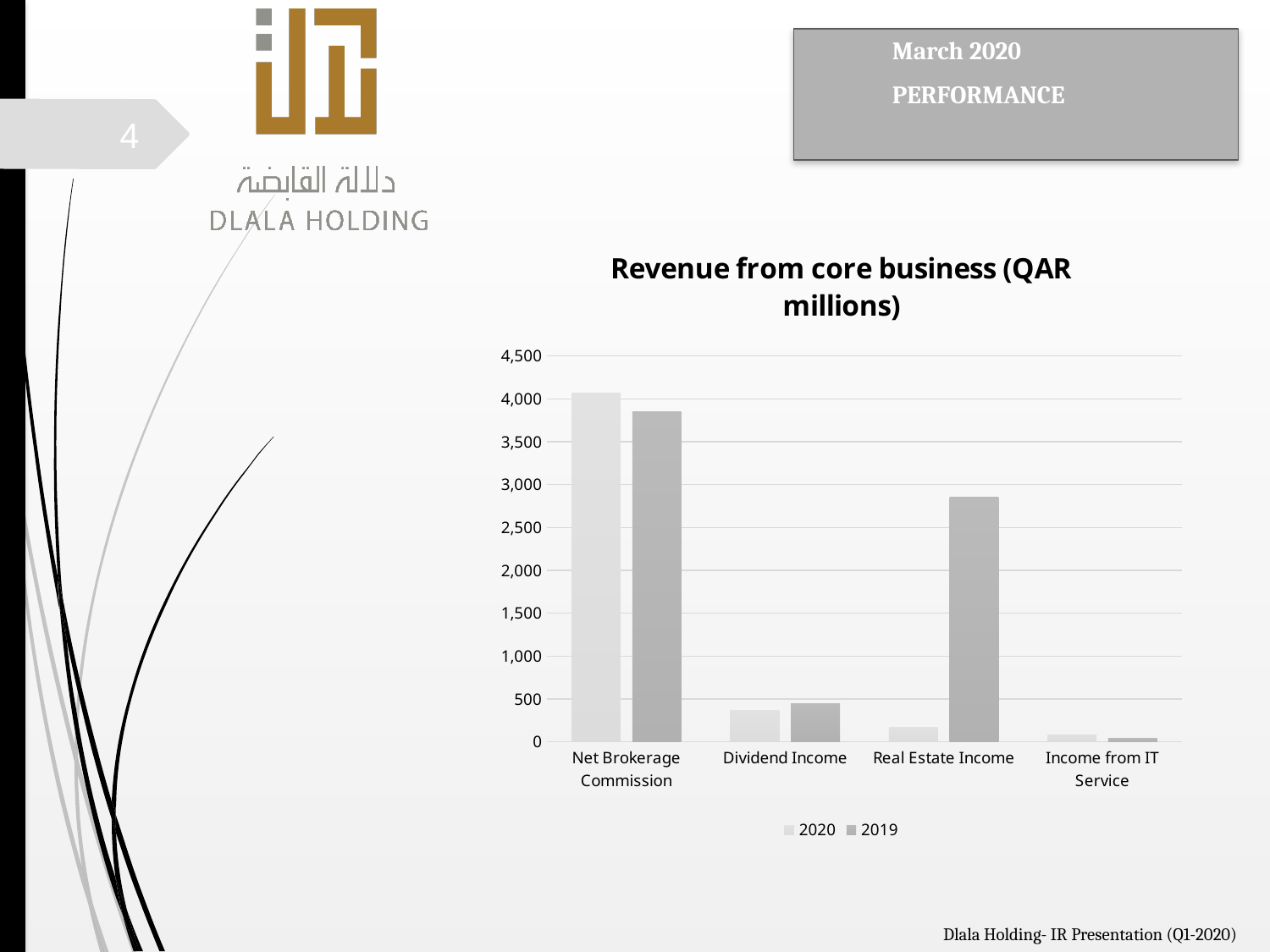
Which category has the lowest value for 2020? Income from IT Service For Net Brokerage Commission, which year has the larger value, 2020 or 2019? 2020 How many series does the legend list? 2 Which category has the highest value for 2019? Net Brokerage Commission Which category has the highest value for 2020? Net Brokerage Commission What kind of chart is shown on the slide? bar chart For Real Estate Income, which year has the larger value, 2020 or 2019? 2019 What is the title of the chart? Revenue from core business (QAR millions) Is the value for Dividend Income in 2019 greater or less than 500? less Is the value for Real Estate Income in 2019 greater or less than 2,500? greater Is the value for Net Brokerage Commission in 2020 greater or less than 3,500? greater How many categories are shown on the x axis? 4